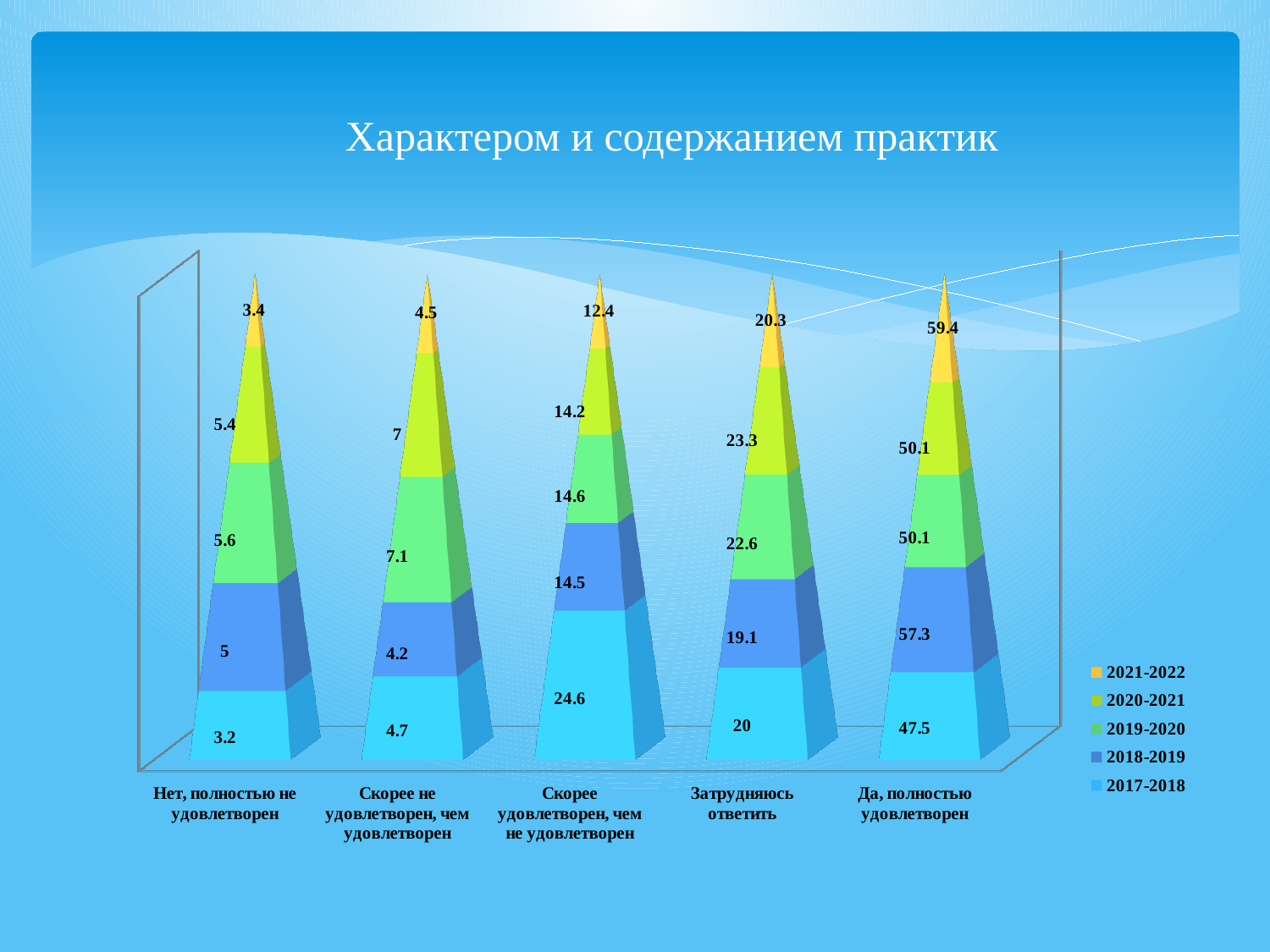
What is the value for 2017-2018 in the category "Да, полностью удовлетворен"? 47.5 What is the value for 2018-2019 in the category "Затрудняюсь ответить"? 19.1 How many series does the legend list? 5 How many categories are shown on the x axis? 5 What is the title of the chart? Характером и содержанием практик Which category has the highest value for the 2021-2022 series? Да, полностью удовлетворен What kind of chart is shown on the slide? Stacked bar chart What is the value for 2021-2022 in the category "Скорее удовлетворен, чем не удовлетворен"? 12.4 What is the total of the stacked bar for the category "Нет, полностью не удовлетворен"? 22.6 Which category has the lowest value for the 2017-2018 series? Нет, полностью не удовлетворен In the category "Скорее удовлетворен, чем не удовлетворен", which is larger: the 2017-2018 value or the 2018-2019 value? 2017-2018 What is the difference between the 2021-2022 and 2017-2018 values in the category "Да, полностью удовлетворен"? 11.9